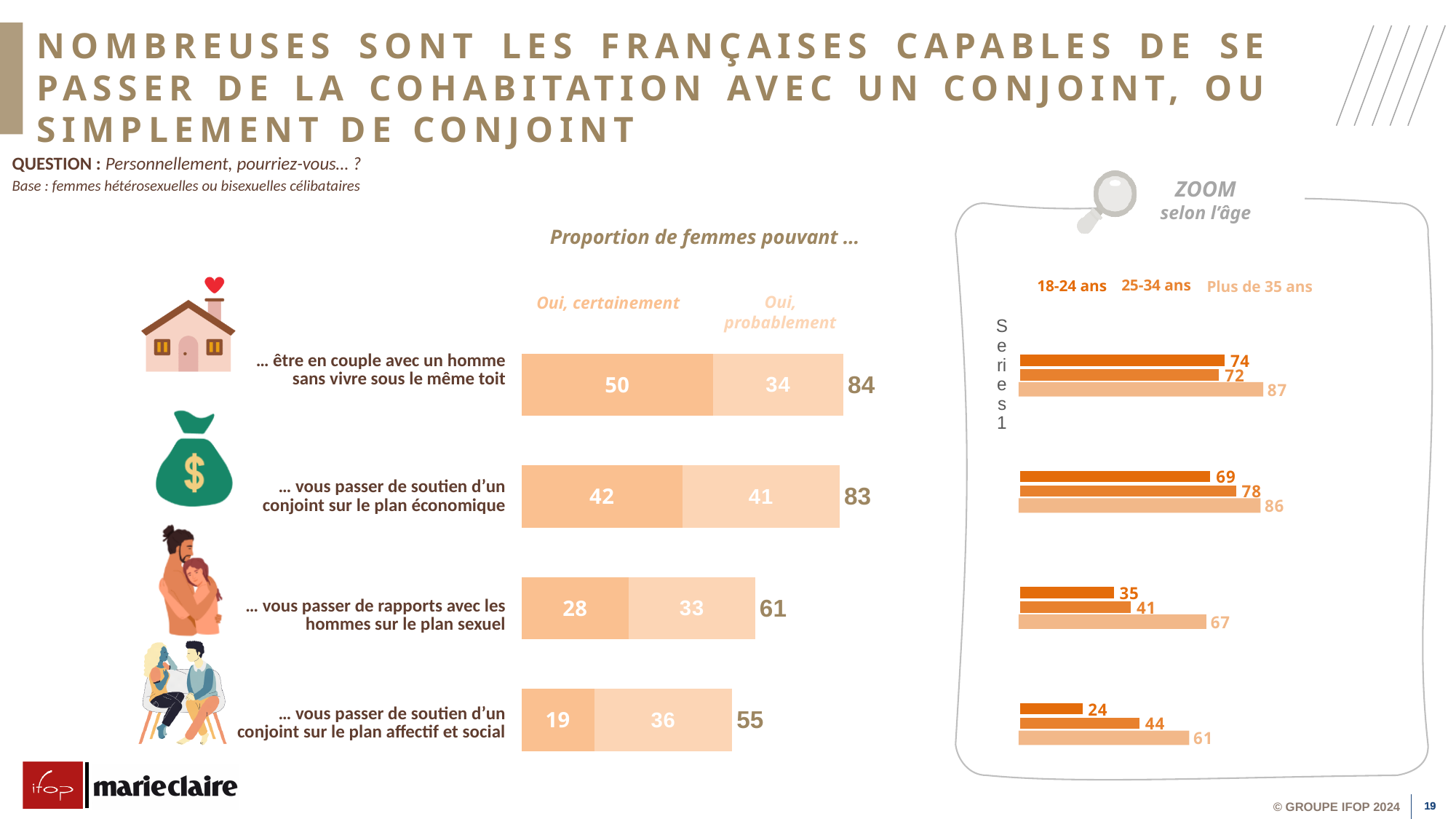
In the 'ZOOM selon l'âge' chart, what is the value for 'Plus de 35 ans' in the third group (rapports avec les hommes sur le plan sexuel)? 67 In the 'Proportion de femmes pouvant ...' chart, which category has the lowest total? ... vous passer de soutien d'un conjoint sur le plan affectif et social What kind of chart is the 'Proportion de femmes pouvant ...' chart? Stacked bar chart In the 'Proportion de femmes pouvant ...' chart, what is the difference between the 'Oui, certainement' values for '... être en couple avec un homme sans vivre sous le même toit' and '... vous passer de soutien d'un conjoint sur le plan affectif et social'? 31 In the 'Proportion de femmes pouvant ...' chart, what is the 'Oui, probablement' value for '... vous passer de soutien d'un conjoint sur le plan économique'? 41 How many age groups does the legend of the 'ZOOM selon l'âge' chart list? 3 In the 'ZOOM selon l'âge' chart, which is larger in the second group (soutien économique): the value for '18-24 ans' or for '25-34 ans'? 25-34 ans In the 'Proportion de femmes pouvant ...' chart, what is the total shown for '... vous passer de rapports avec les hommes sur le plan sexuel'? 61 In the 'Proportion de femmes pouvant ...' chart, what is the 'Oui, certainement' value for '... être en couple avec un homme sans vivre sous le même toit'? 50 In the 'ZOOM selon l'âge' chart, what is the value for '18-24 ans' in the first group (être en couple sans vivre sous le même toit)? 74 How many series does the 'Proportion de femmes pouvant ...' chart show? 2 In the 'ZOOM selon l'âge' chart, which age group has the highest value in the fourth group (soutien d'un conjoint sur le plan affectif et social)? Plus de 35 ans